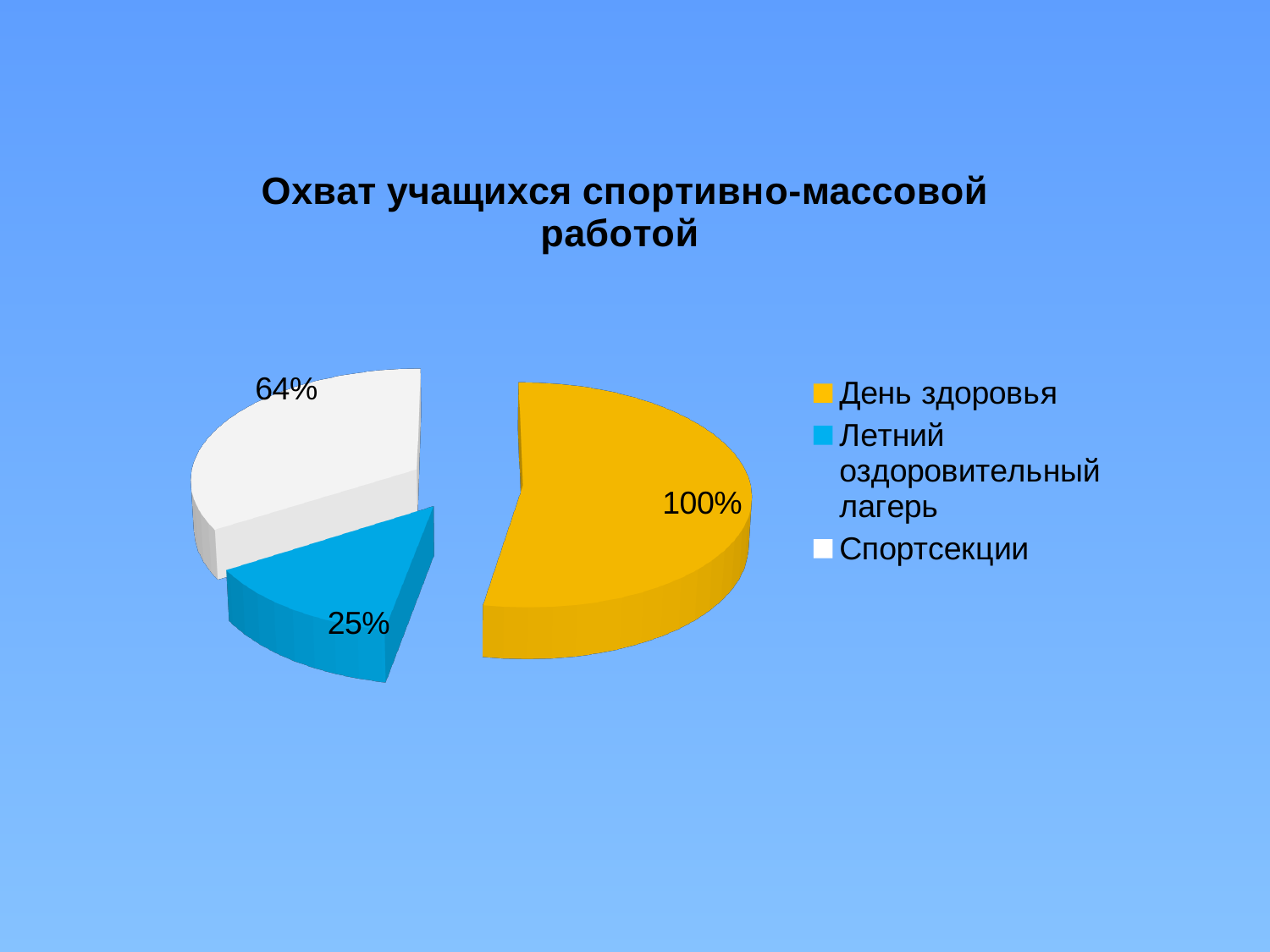
What is the difference between the values for День здоровья and Спортсекции? 36% What value is shown for Спортсекции? 64% What value is shown for Летний оздоровительный лагерь? 25% How many categories does the pie chart show? 3 What value is shown for День здоровья? 100% What type of chart is shown on the slide? pie chart Which colour represents Летний оздоровительный лагерь in the legend? blue Which category has the highest value? День здоровья What is the difference between the values for Спортсекции and Летний оздоровительный лагерь? 39% What is the title of the chart? Охват учащихся спортивно-массовой работой Which category has the lowest value? Летний оздоровительный лагерь Which is larger, the value for Спортсекции or the value for Летний оздоровительный лагерь? Спортсекции